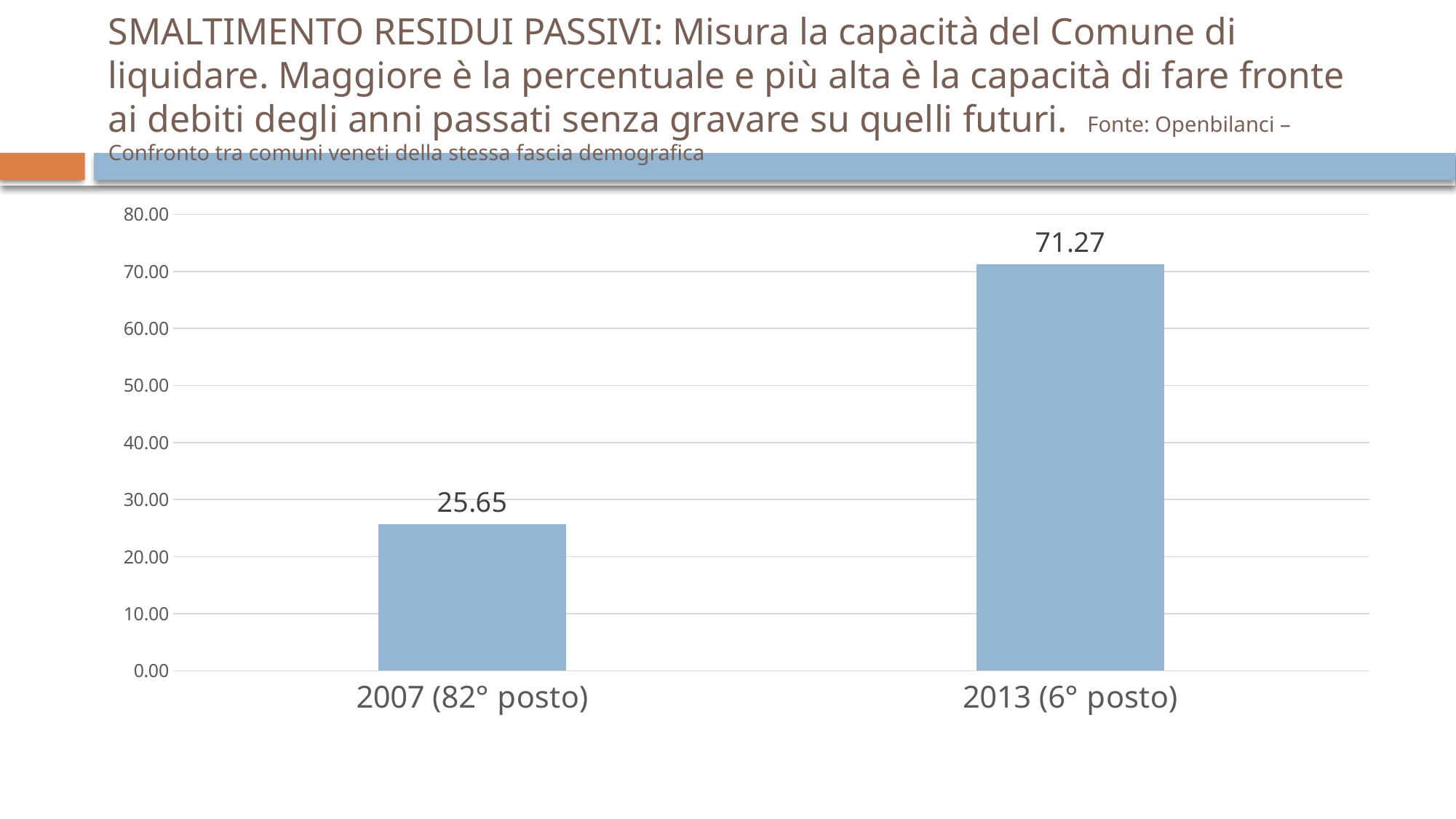
What is the value for 2007 (82° posto)? 25.65 Which category has the lowest value? 2007 (82° posto) Do the values rise or fall from 2007 to 2013? Rise Which category has the highest value? 2013 (6° posto) What is the value for 2013 (6° posto)? 71.27 What is the highest value shown on the vertical axis? 80.00 Is the value for 2013 (6° posto) greater or less than 70.00? greater Which is larger, the value for 2007 (82° posto) or the value for 2013 (6° posto)? 2013 (6° posto) What is the difference between the values for 2013 (6° posto) and 2007 (82° posto)? 45.62 How many categories are shown on the chart? 2 Is the value for 2007 (82° posto) greater or less than 30.00? less What kind of chart is shown on the slide? Bar chart